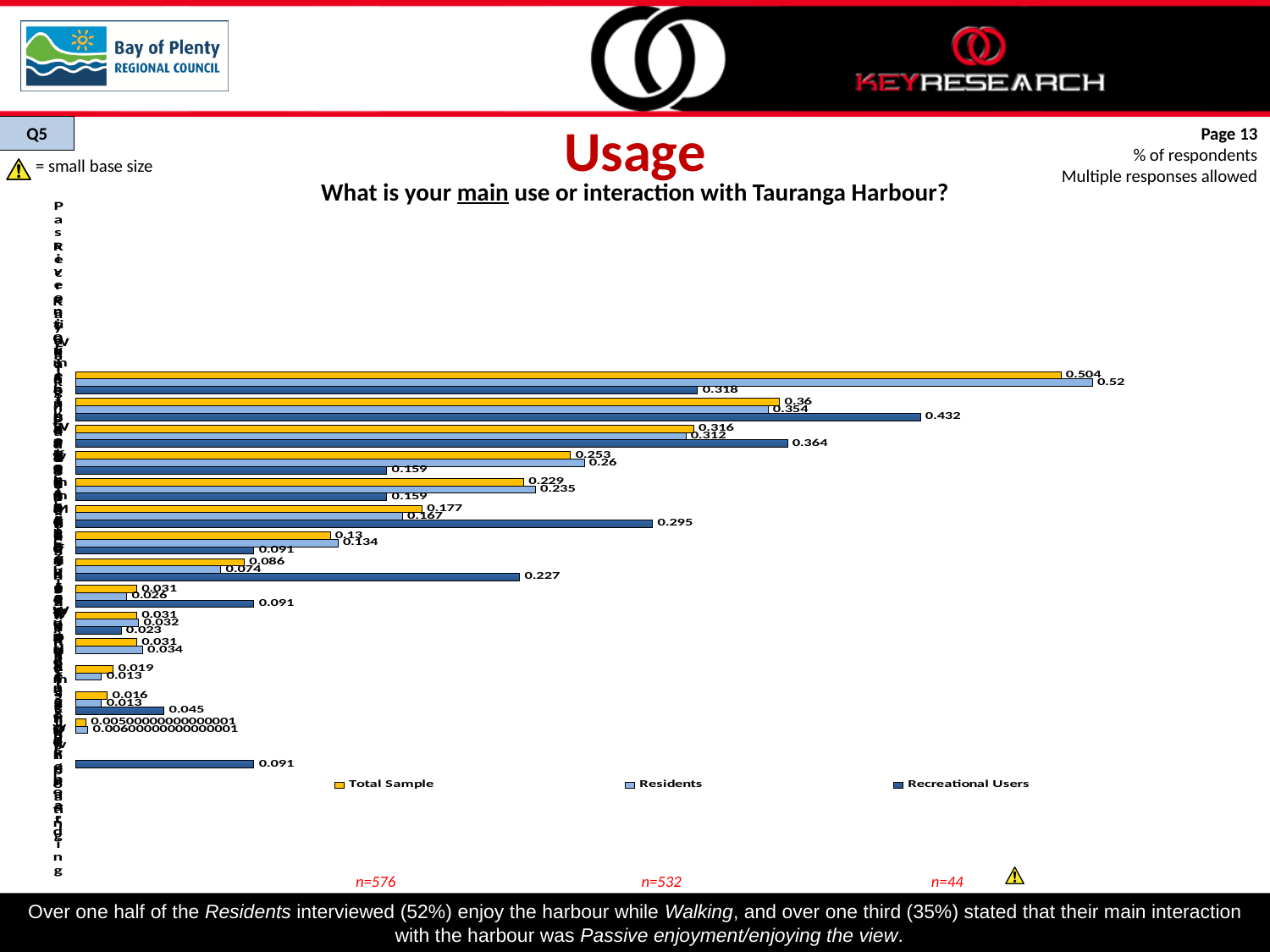
In the top group of bars, which series has the highest value? Residents What are the three series named in the chart's legend? Total Sample, Residents, Recreational Users What kind of chart is shown on the slide? bar chart In the top group of bars, what is the value for Total Sample? 0.504 What is the highest value labelled anywhere on the chart? 0.52 How many series does the chart's legend list? 3 In the second group of bars from the top, what is the value for Recreational Users? 0.432 In the top group of bars, what is the value for Recreational Users? 0.318 In the top group of bars, what is the difference between the Residents value and the Recreational Users value? 0.202 What sample size (n) is shown for Recreational Users below the chart? n=44 In the second group of bars from the top, which series has the highest value? Recreational Users In the third group of bars from the top, which is larger: the Total Sample value or the Recreational Users value? Recreational Users